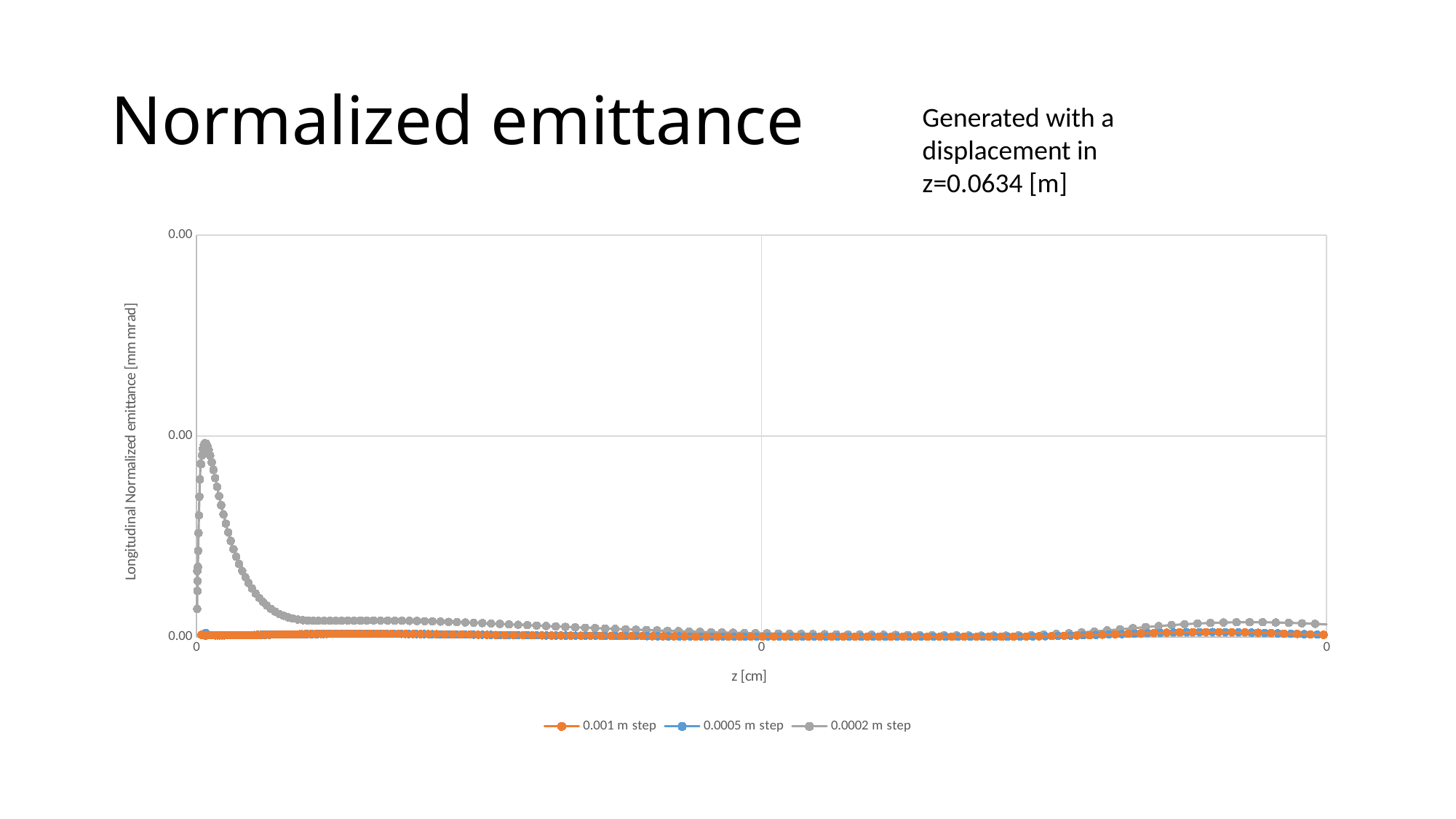
Which series reaches the highest value on the chart? 0.0002 m step What is the label of the y axis? Longitudinal Normalized emittance [mm mrad] What kind of chart is shown on the slide? line chart What is the label of the x axis? z [cm] How many series does the legend list? 3 After its early peak, does the 0.0002 m step series rise or fall as z increases? fall Which series is larger near the left of the chart, 0.0002 m step or 0.001 m step? 0.0002 m step